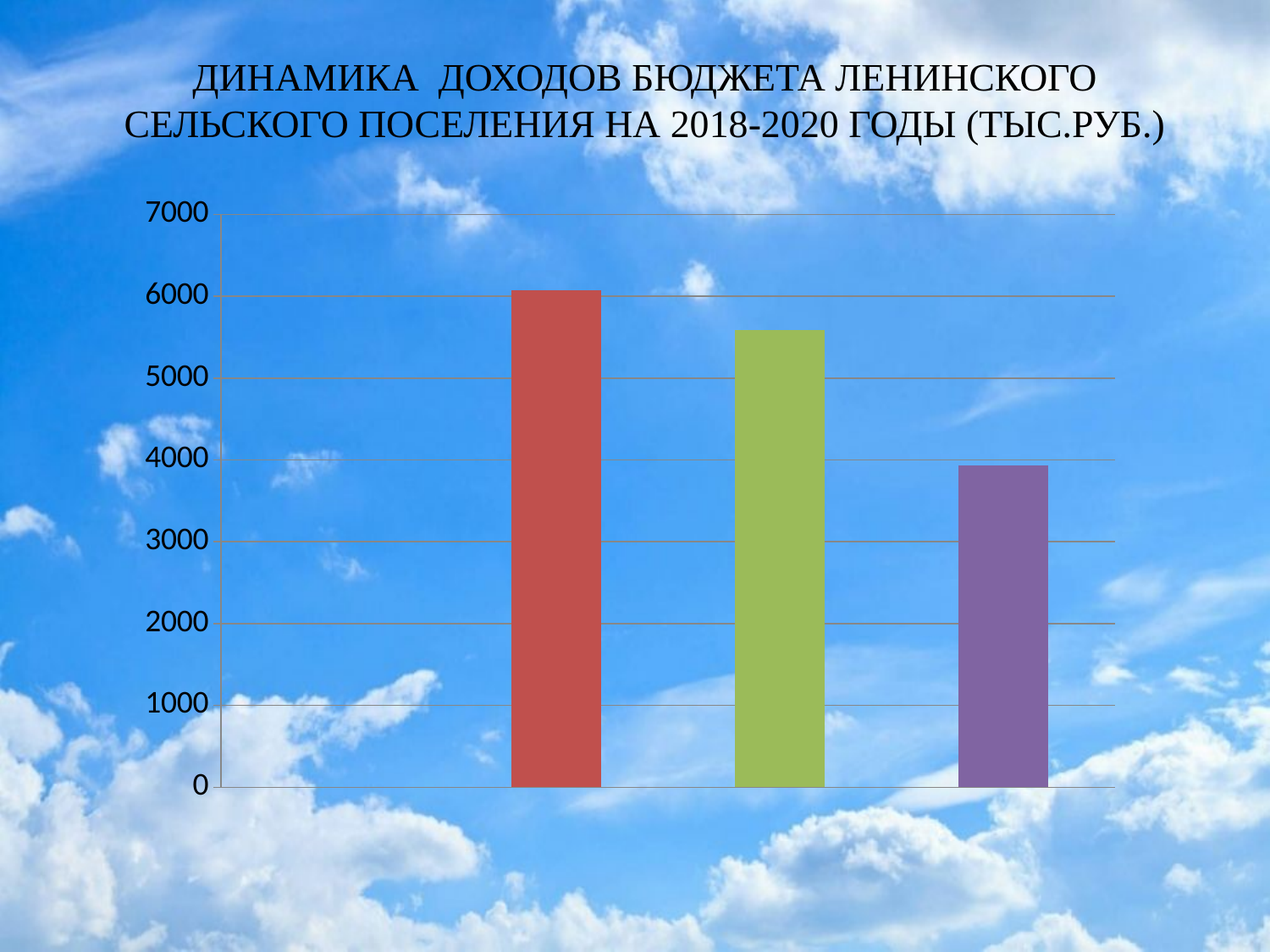
Is the value of the purple (rightmost) bar greater or less than 3000? greater Is the value of the red (leftmost) bar greater or less than 5000? greater How many bars are plotted in the chart? 3 Which bar is the shortest in the chart: the red, green or purple one? purple Is the value of the green (middle) bar greater or less than 5000? greater Which is larger, the value of the green bar or the value of the purple bar? green bar In what units are the budget revenues given according to the slide title? тыс.руб. What kind of chart is shown on the slide? bar chart Which bar is the tallest in the chart: the red, green or purple one? red What is the maximum value shown on the vertical axis of the chart? 7000 Do the bar values rise or fall from left to right across the chart? fall